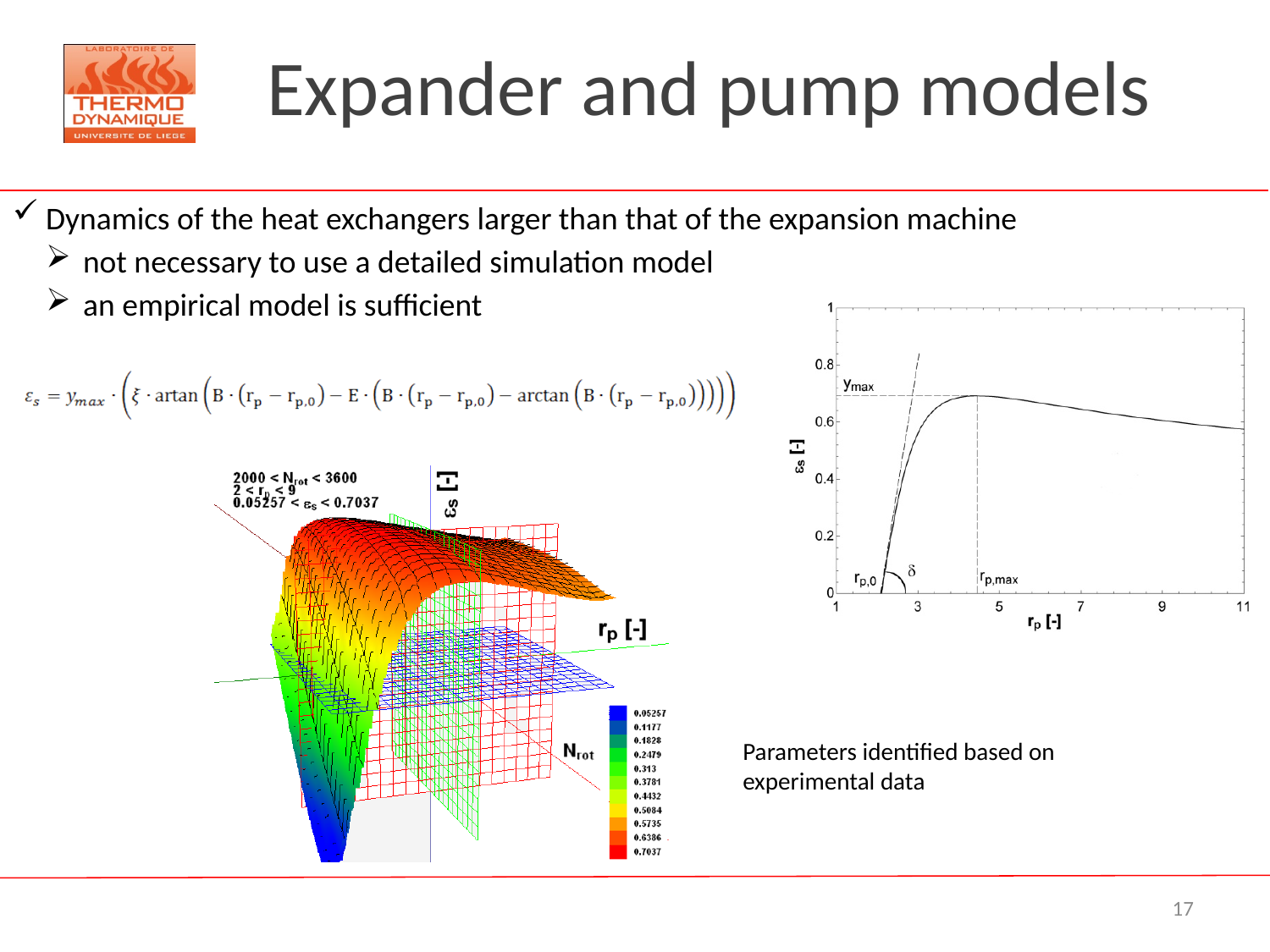
In the chart on the right, do the values of ε_s rise or fall as r_p increases from r_p,0 to r_p,max? rise In the chart on the right, is the peak value y_max of the curve greater or less than 0.8? less What kind of chart is the chart on the right of the slide? line chart In the chart on the right, do the values of ε_s rise or fall as r_p increases beyond r_p,max? fall What kind of chart is the chart on the left of the slide? 3D surface plot In the chart on the right, is the peak value y_max of the curve greater or less than 0.6? greater In the chart on the right, what is the label of the y axis? ε_s [-] In the chart on the left, how many values are listed on the colour scale? 11 In the chart on the left, what is the lowest ε_s value shown on the colour scale? 0.05257 In the chart on the left, what is the highest ε_s value shown on the colour scale? 0.7037 In the chart on the right, what is the label of the x axis? r_p [-] In the chart on the right, what is the largest value shown on the x axis? 11